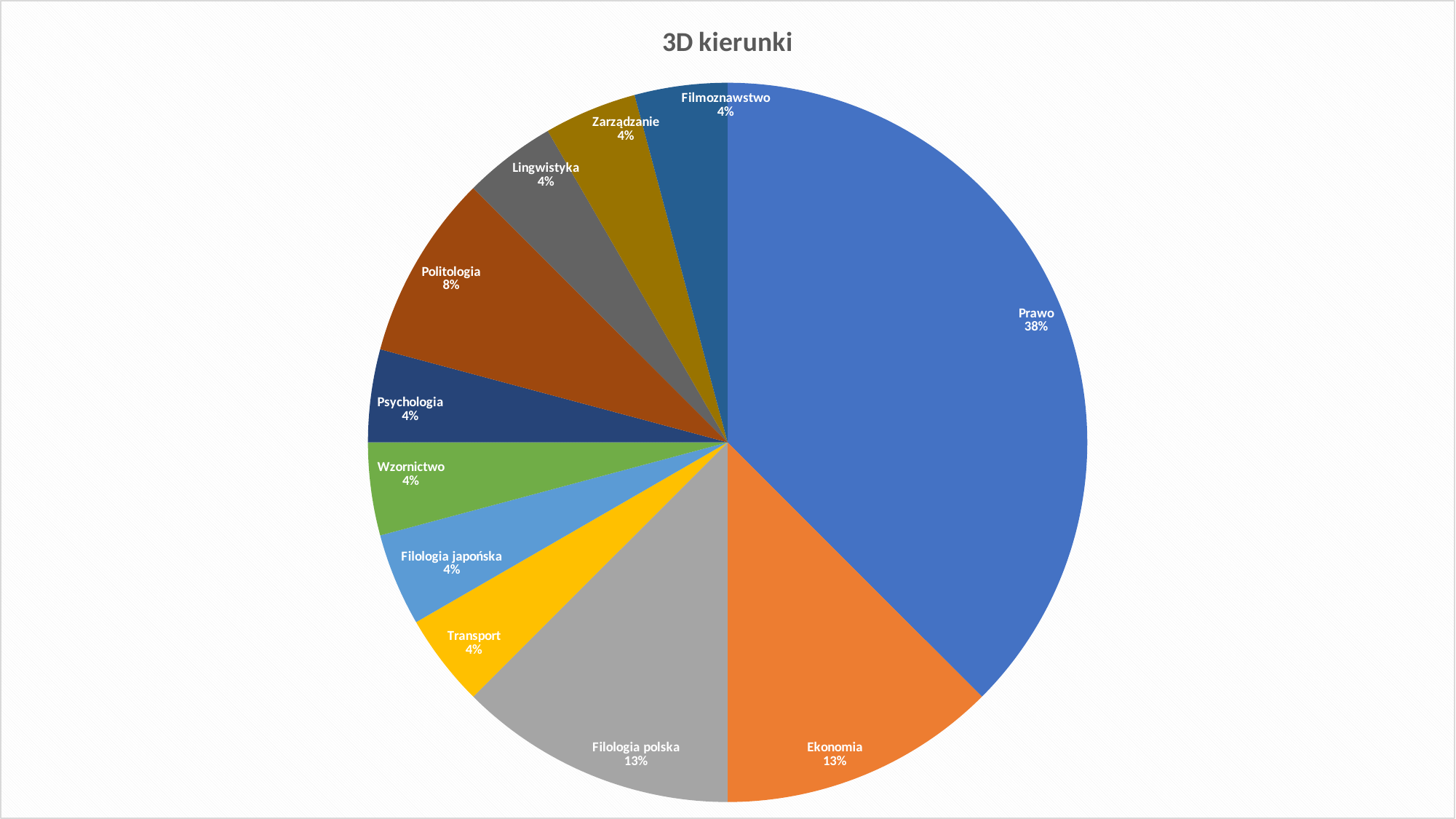
What share of the pie does Prawo have? 38% What kind of chart is shown on the slide? pie chart What is the value shown for Filologia polska? 13% How many slices does the pie chart have? 11 Which category has the largest slice of the pie? Prawo Which is larger, the share for Politologia or the share for Lingwistyka? Politologia What is the title of the chart? 3D kierunki What share of the pie does Ekonomia have? 13% What is the value shown for Transport? 4% What is the difference between the shares of Prawo and Ekonomia? 25% What share of the pie does Politologia have? 8% What is the difference between the shares of Politologia and Psychologia? 4%